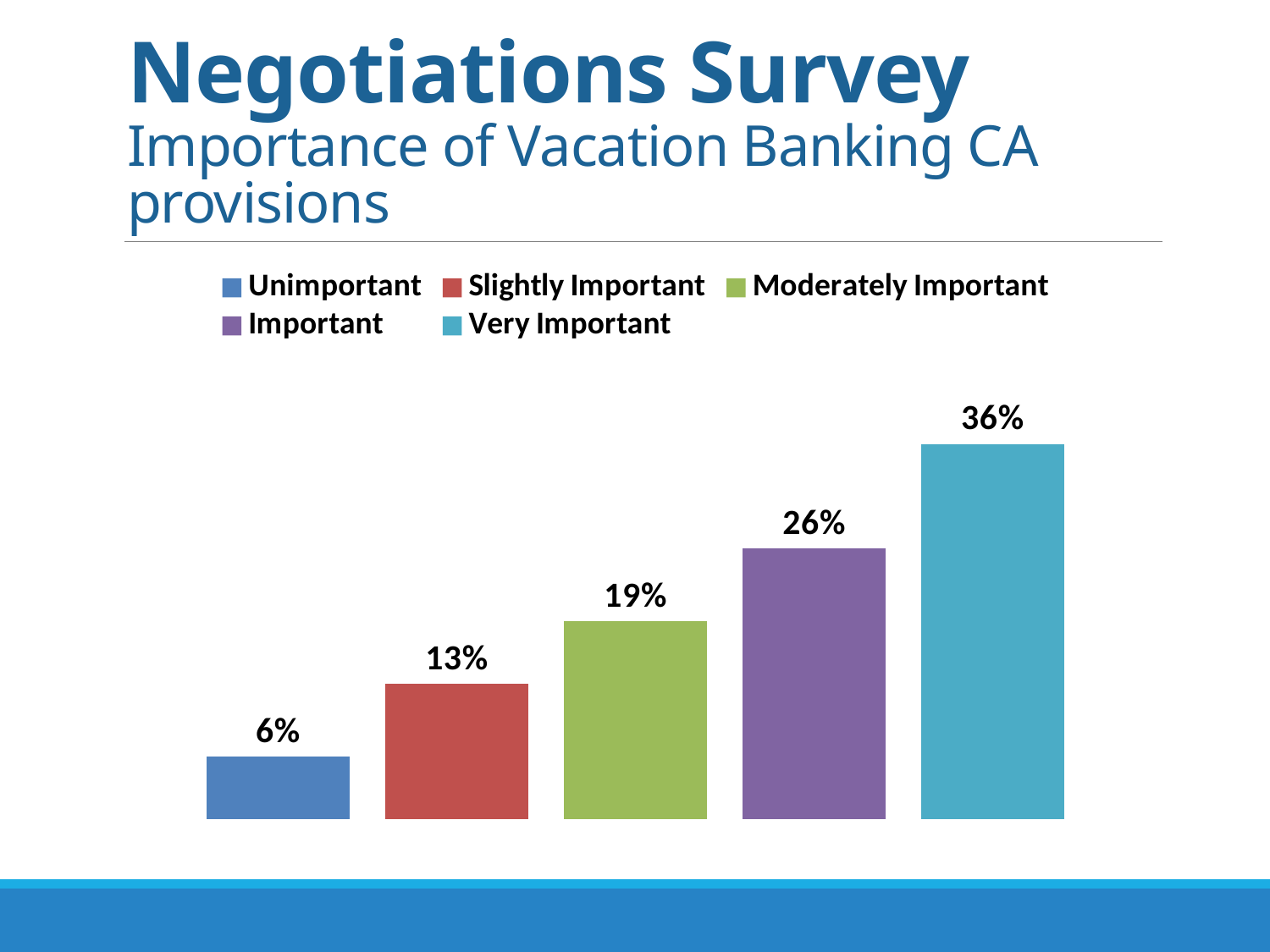
How many categories are plotted in the chart? 5 Which category has the highest value? Very Important What is the value for Slightly Important? 13% What percentage of respondents rated the provisions as Very Important? 36% Which is larger, the value for Important or the value for Moderately Important? Important Do the values rise or fall from left to right across the chart? Rise What percentage is shown for Moderately Important? 19% Which category has the lowest value? Unimportant What is the value shown for Unimportant? 6% What is the difference between the Very Important and Important values? 10% What is the difference between the Moderately Important and Slightly Important values? 6% What kind of chart is shown on the slide? Bar chart